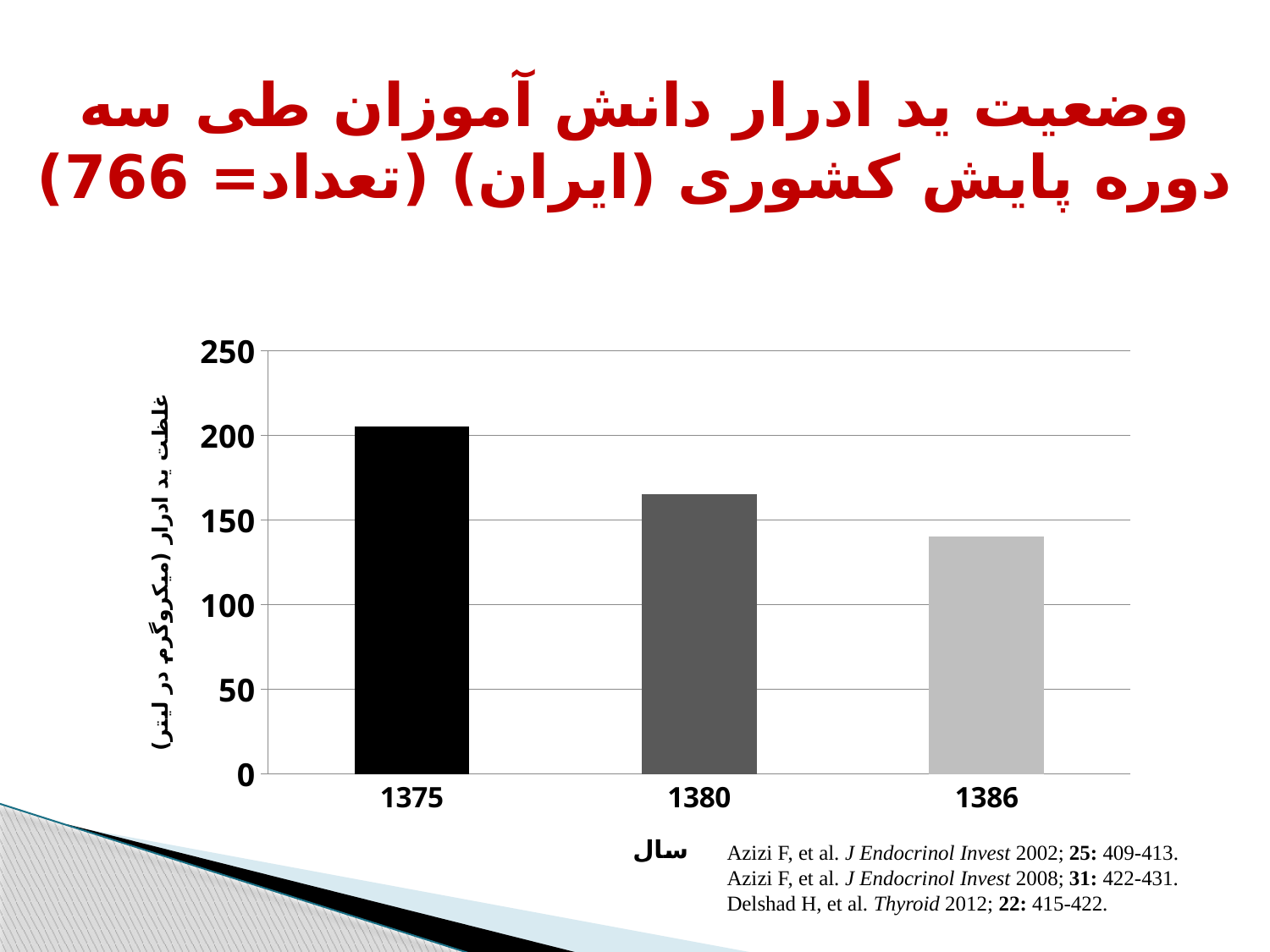
Is the value for 1380 greater or less than 150? greater Do the values rise or fall from 1375 to 1386 along the x axis? fall Is the value for 1386 greater or less than 150? less What kind of chart is shown on the slide? bar chart Is the value for 1375 greater or less than 150? greater How many bars (years) are plotted in the chart? 3 Which year has the highest bar in the chart? 1375 Which year has the lowest bar in the chart? 1386 Which is larger, the value for 1375 or the value for 1386? 1375 What is the label on the x axis of the chart? سال Which is larger, the value for 1380 or the value for 1386? 1380